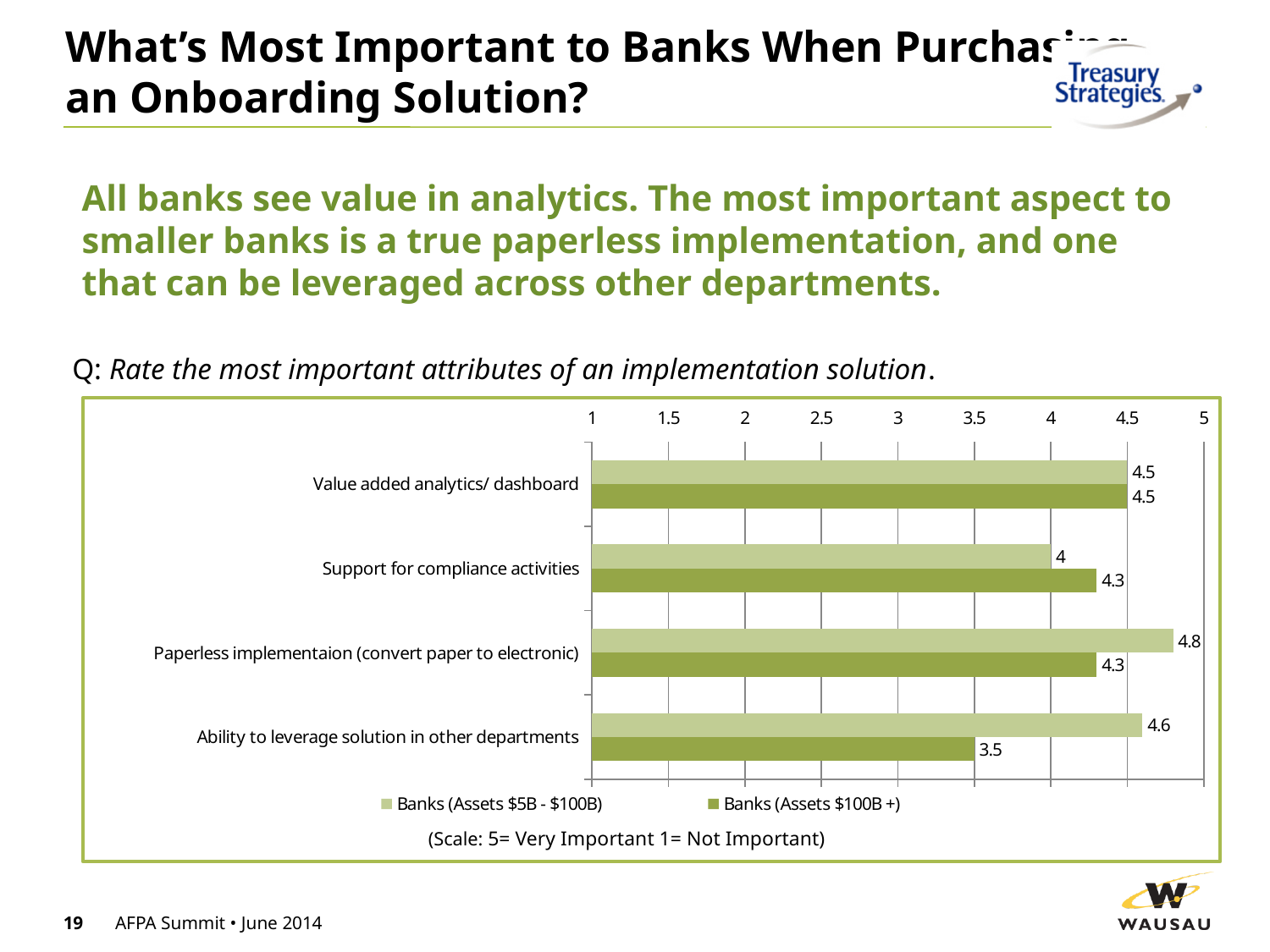
What is the difference between the two series for Ability to leverage solution in other departments? 1.1 What is the value for Banks (Assets $100B +) for Ability to leverage solution in other departments? 3.5 What is the value for Banks (Assets $100B +) for Support for compliance activities? 4.3 What is the value for Banks (Assets $5B - $100B) for Paperless implementaion (convert paper to electronic)? 4.8 Which category has the lowest value for Banks (Assets $100B +)? Ability to leverage solution in other departments How many categories are shown on the chart? 4 For Support for compliance activities, which series has the larger value? Banks (Assets $100B +) What is the value for Banks (Assets $5B - $100B) for Value added analytics/ dashboard? 4.5 What scale note is shown below the legend? (Scale: 5= Very Important 1= Not Important) Which category has the highest value for Banks (Assets $5B - $100B)? Paperless implementaion (convert paper to electronic) How many series does the legend list? 2 What kind of chart is shown on the slide? Bar chart